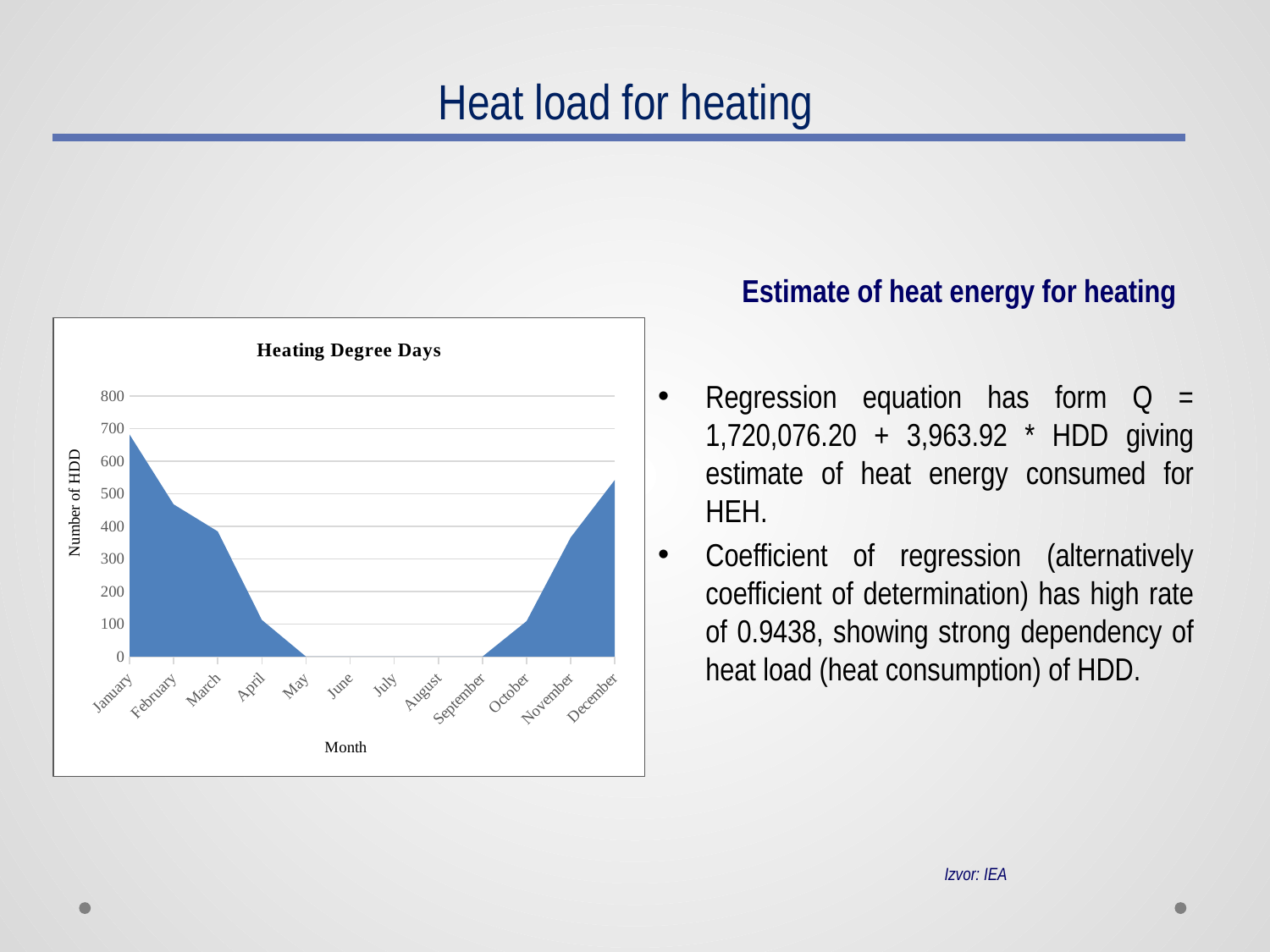
Is the value for March greater or less than 300? greater Which is larger, the value for January or the value for December? January What is the title of the chart? Heating Degree Days Do the values rise or fall from January to May? fall What kind of chart is shown on the slide? Area chart Which is larger, the value for February or the value for October? February Is the value for April greater or less than 200? less Is the value for December greater or less than 500? greater What is the label of the vertical axis of the chart? Number of HDD How many months are shown on the x axis of the chart? 12 Which month has the highest number of HDD? January